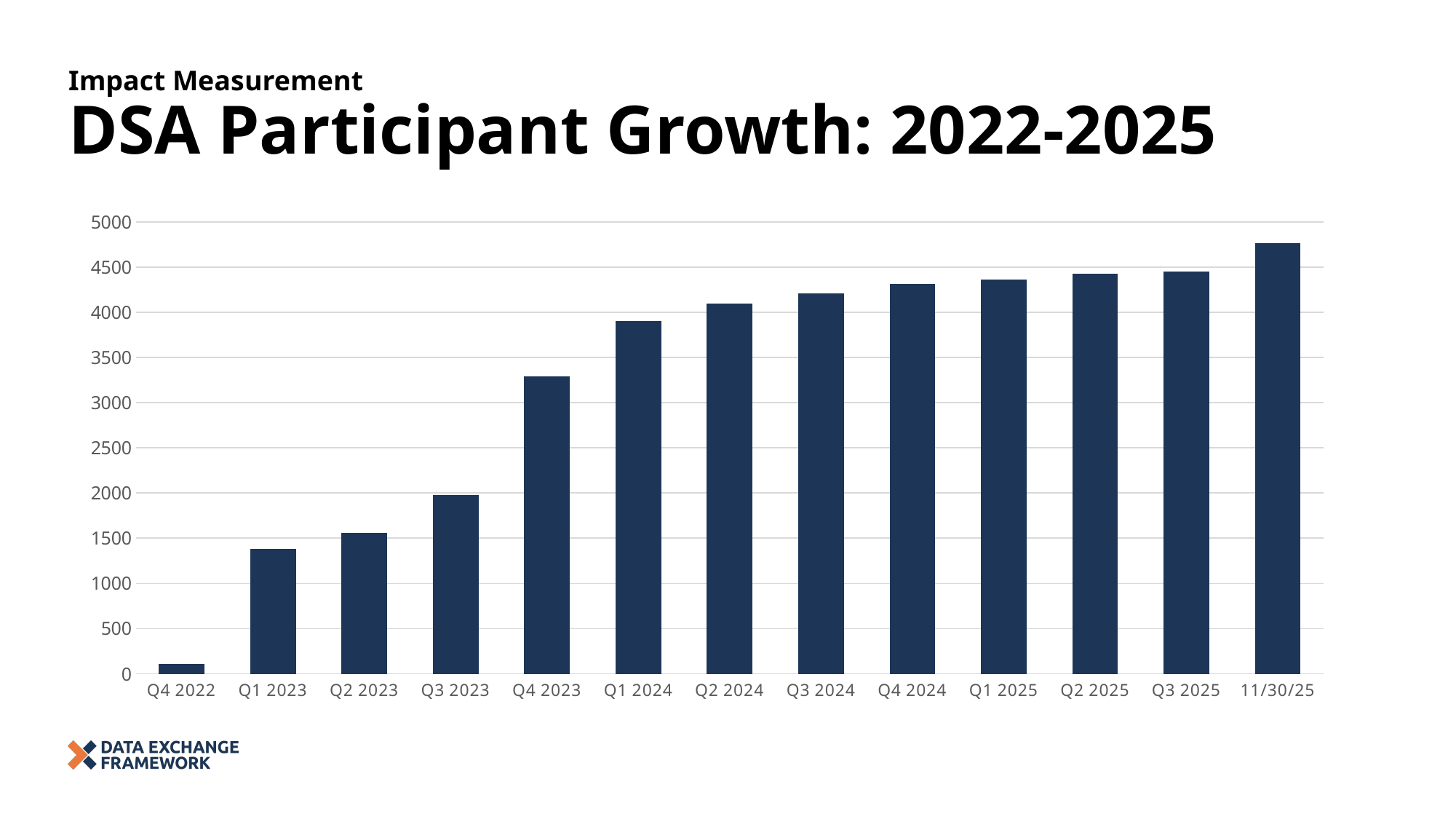
How many periods (bars) are shown on the x axis? 13 Which period has the highest value? 11/30/25 Is the value for Q1 2023 greater or less than 1500? less Is the value for Q3 2024 greater or less than 4000? greater Which period has the lowest value? Q4 2022 Is the value for 11/30/25 greater or less than 4500? greater Which is larger, the value for Q3 2023 or the value for Q4 2023? Q4 2023 Do the values generally rise or fall from Q4 2022 to 11/30/25? Rise What is the title of the chart? DSA Participant Growth: 2022-2025 What type of chart is shown on the slide? Bar chart